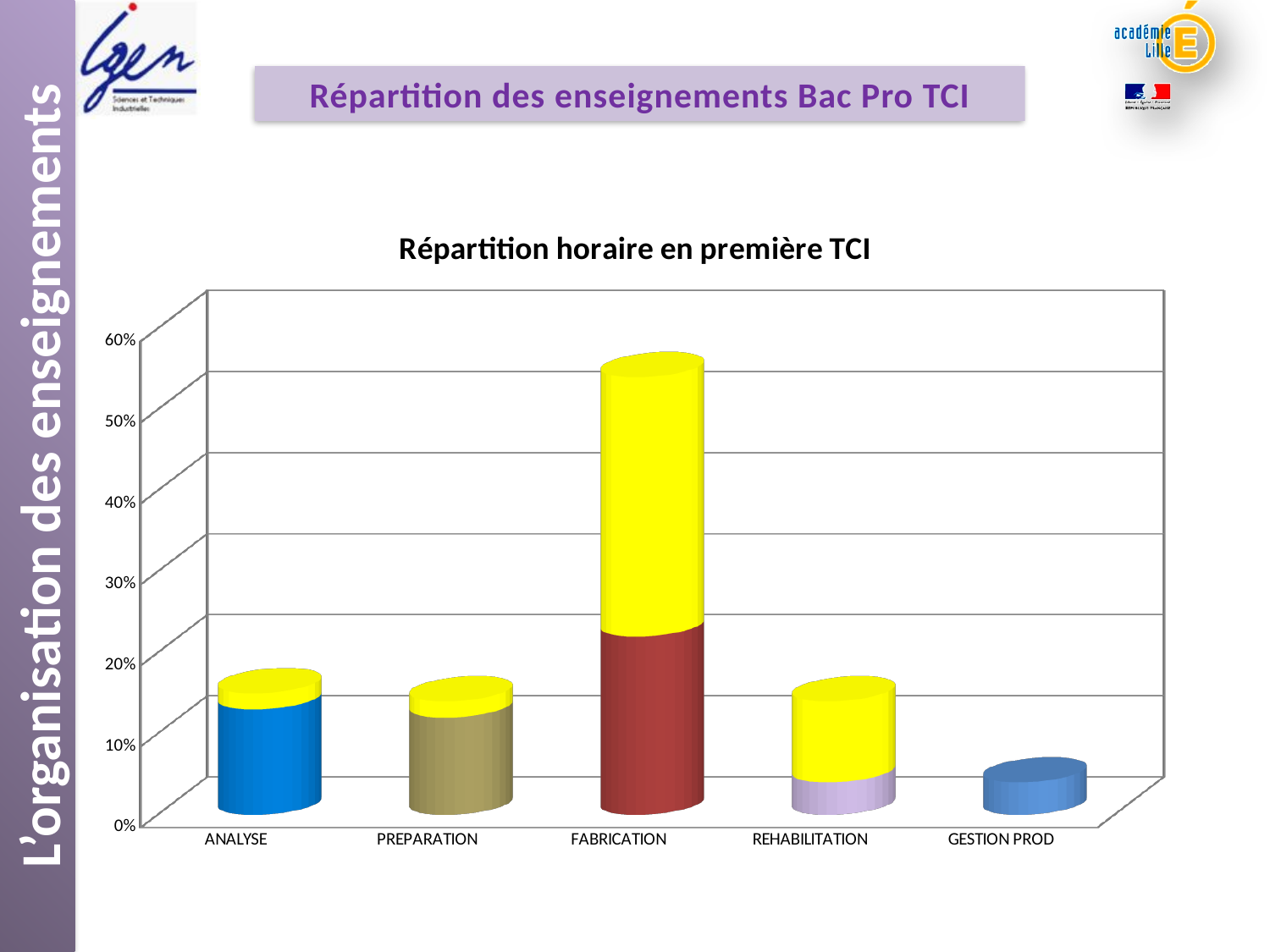
What is the highest value shown on the y axis of the chart? 60% Which is larger, the bar for FABRICATION or the bar for ANALYSE? FABRICATION How many categories are shown on the x axis of the chart? 5 Is the value for ANALYSE greater or less than 10%? greater Is the value for GESTION PROD greater or less than 10%? less Is the value for ANALYSE greater or less than 20%? less Which category has the lowest bar in the chart? GESTION PROD What is the title of the chart? Répartition horaire en première TCI Which category has the highest bar in the chart? FABRICATION What kind of chart is shown on the slide? bar chart Which is larger, the bar for REHABILITATION or the bar for GESTION PROD? REHABILITATION